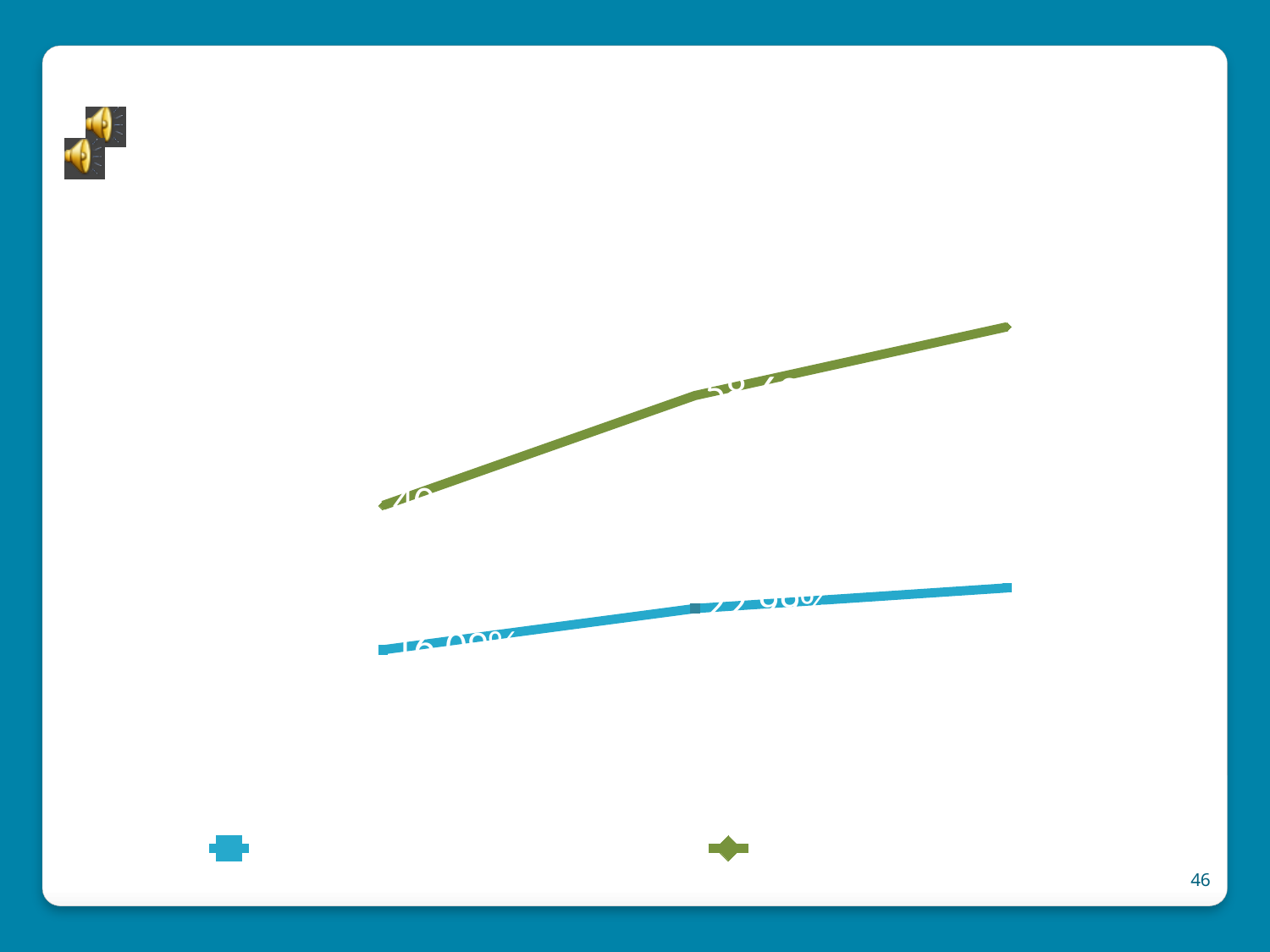
Which line is plotted higher on the chart, the green line or the blue line? the green line Where is the legend positioned on the slide? at the bottom What kind of chart is shown on the slide? line chart How many data points does the green line have? 3 Do the values of the green line rise or fall from left to right? rise How many data points does the blue line have? 3 What colours are the two lines on the chart? green and blue Do the values of the blue line rise or fall from left to right? rise How many series does the legend list? 2 Which series has the lowest values at every point, the green series or the blue series? the blue series